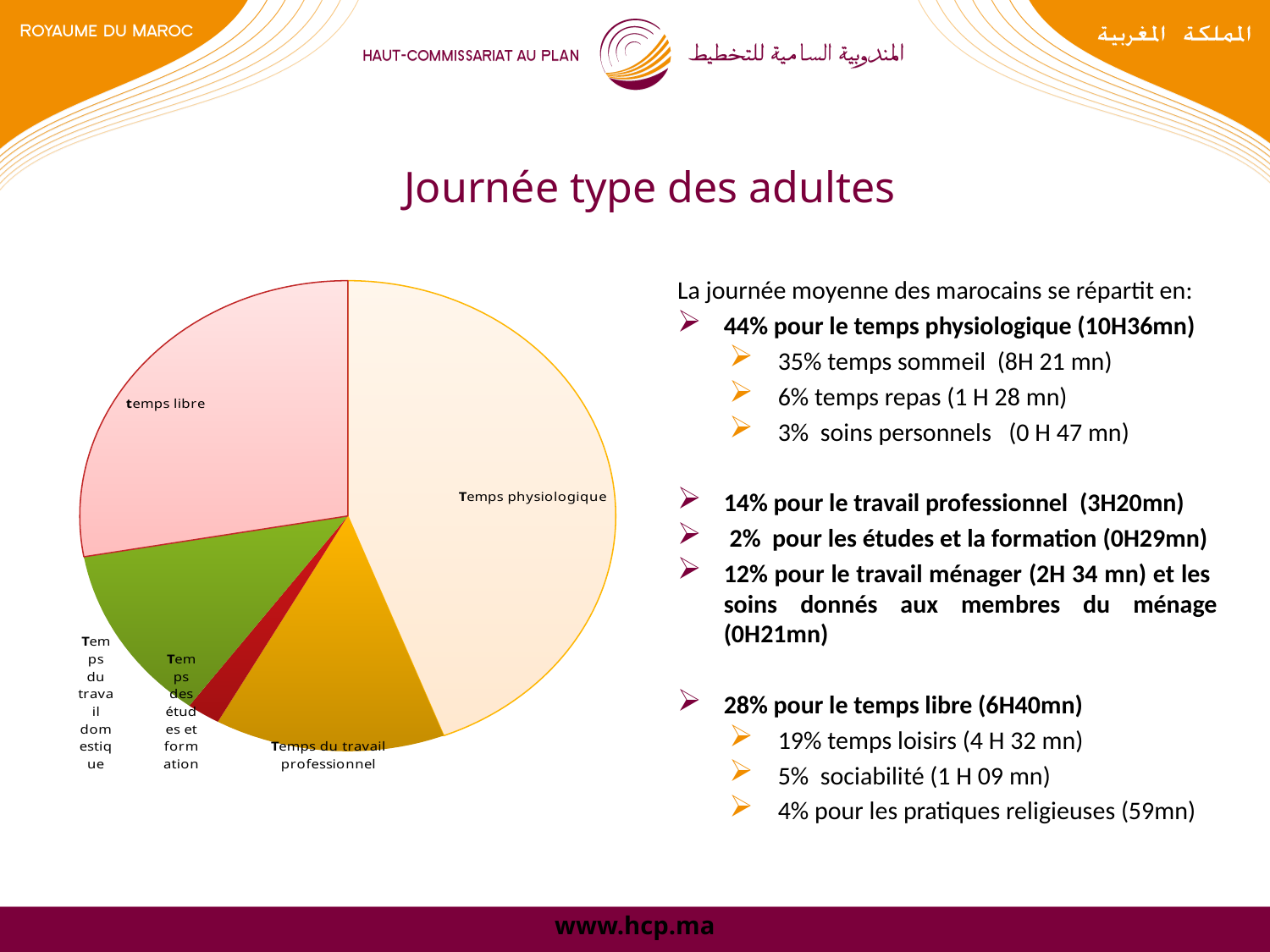
According to the slide, what share of the day is Temps des études et formation? 2% According to the slide, what share of the day is Temps physiologique? 44% What kind of chart is shown on the slide? pie chart According to the slide, what share of the day is temps libre? 28% Which slice of the pie chart is the largest? Temps physiologique Which slice is larger: temps libre or Temps du travail professionnel? temps libre What colour is the temps libre slice of the pie chart? pink Which slice of the pie chart is the smallest? Temps des études et formation How many slices does the pie chart have? 5 What is the title of the slide containing the pie chart? Journée type des adultes Which slice is larger: Temps physiologique or temps libre? Temps physiologique